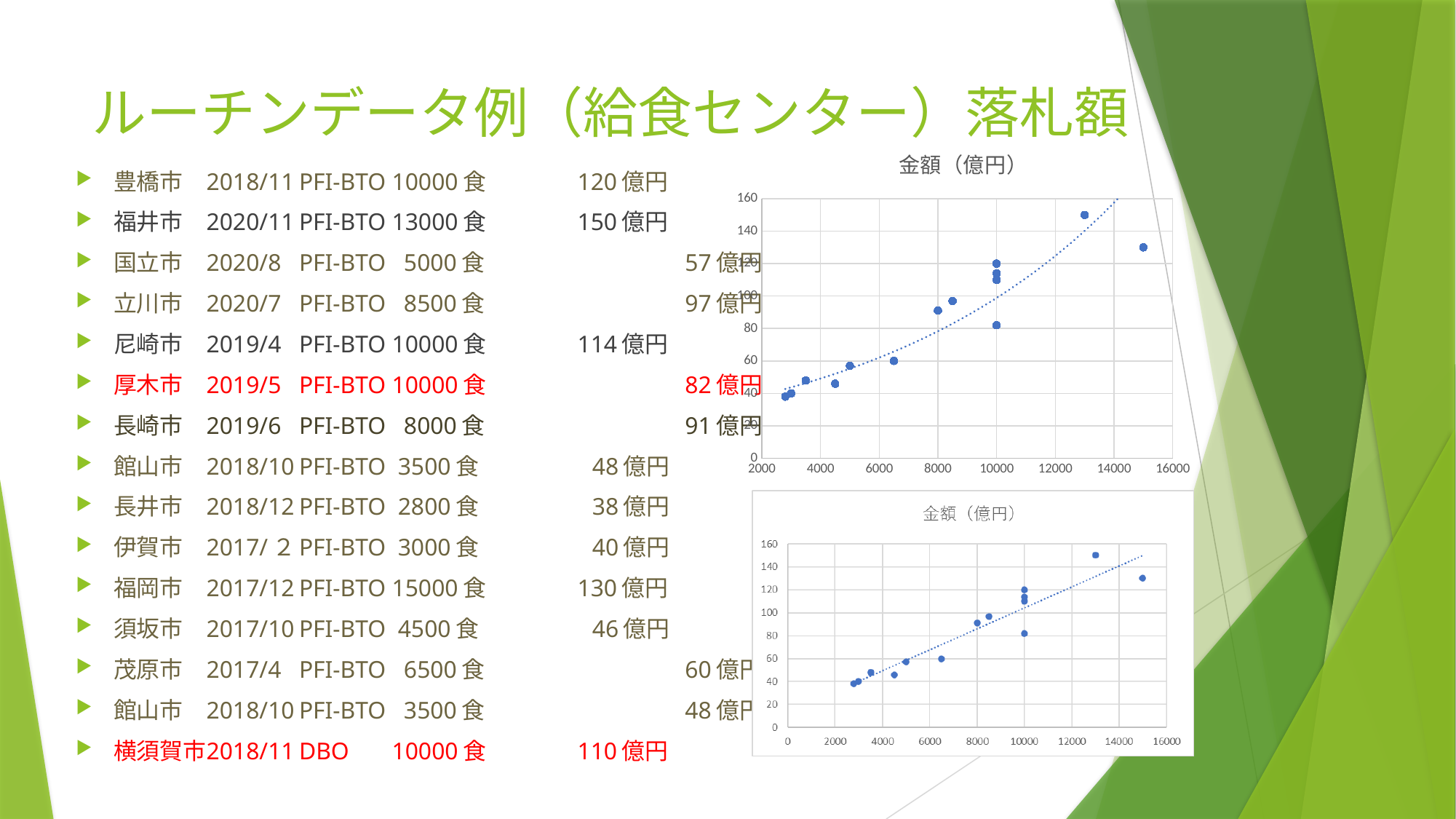
In the top chart, do the plotted values generally rise or fall as the x value increases? rise In the top chart, is the value of the point at x = 15000 greater or less than 120? greater In the bottom chart, do the plotted values generally rise or fall as the x value increases? rise What kind of chart is the bottom chart on the slide? scatter chart What is the title of the top chart? 金額（億円） In the bottom chart, is the value of the point at x = 13000 greater or less than 140? greater What kind of chart is the top chart on the slide? scatter chart In the top chart, is the value of the point at x = 4500 greater or less than 60? less What is the maximum value shown on the y axis of the bottom chart? 160